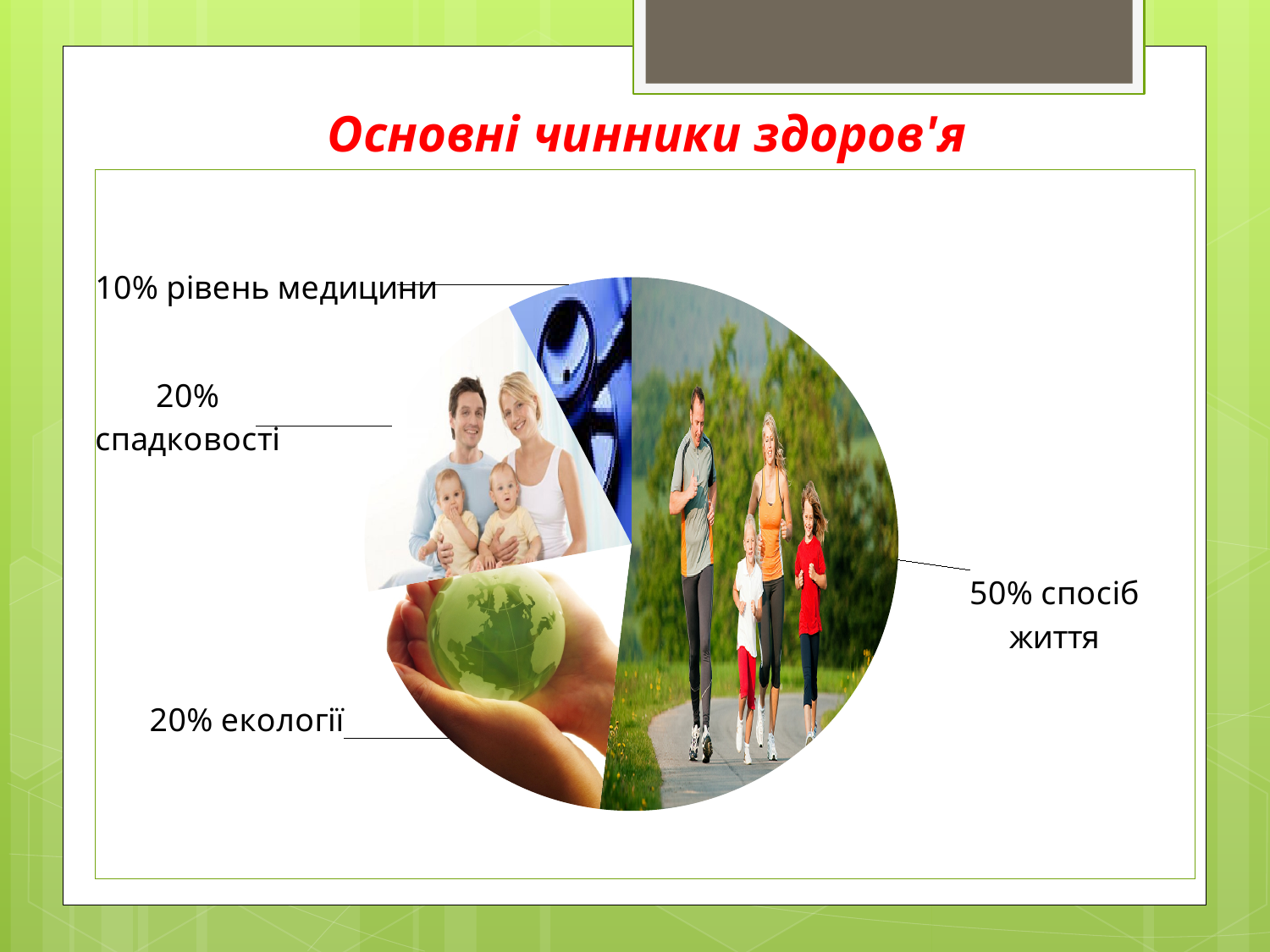
Which factor has the largest slice of the pie? спосіб життя Which is larger: the share for "спадковості" or the share for "рівень медицини"? спадковості What is the difference between the share for "спосіб життя" and the share for "екології"? 30% What share of the pie does "спосіб життя" take? 50% How many slices does the pie chart have? 4 What is the value shown for "спадковості"? 20% Which factor has the smallest slice of the pie? рівень медицини What is the difference between the share for "спадковості" and the share for "рівень медицини"? 10% What is the title of the chart on the slide? Основні чинники здоров'я What is the value shown for "екології"? 20% What share of the pie does "рівень медицини" take? 10% What kind of chart is shown on the slide? pie chart